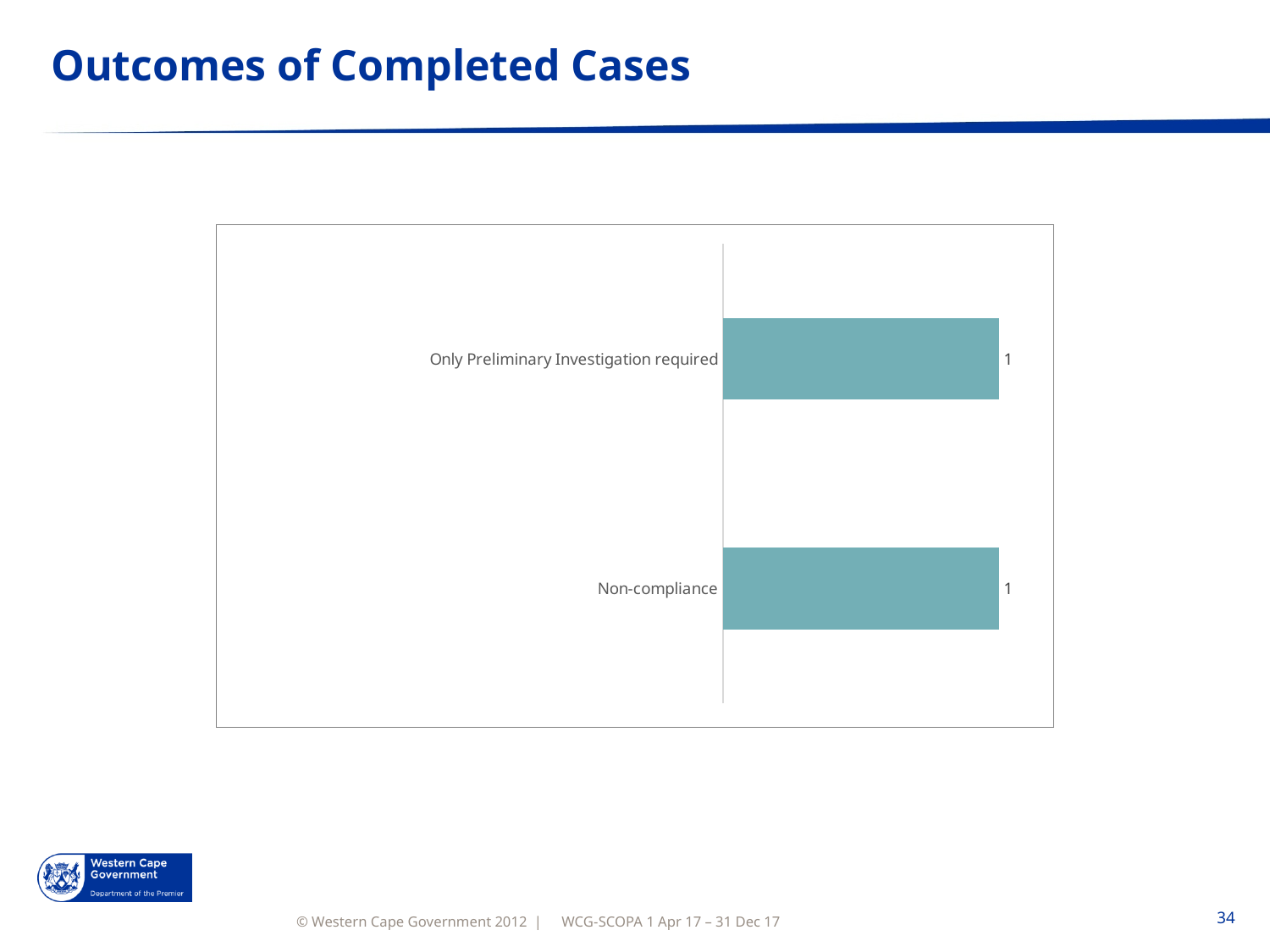
How many categories are shown in the chart? 2 What is the total of the values for Only Preliminary Investigation required and Non-compliance? 2 What is the value for Non-compliance? 1 Are the bars in the chart horizontal or vertical? horizontal What is the value for Only Preliminary Investigation required? 1 What is the difference between the values for Only Preliminary Investigation required and Non-compliance? 0 What kind of chart is shown on the slide? bar chart What is the title of the slide containing the chart? Outcomes of Completed Cases